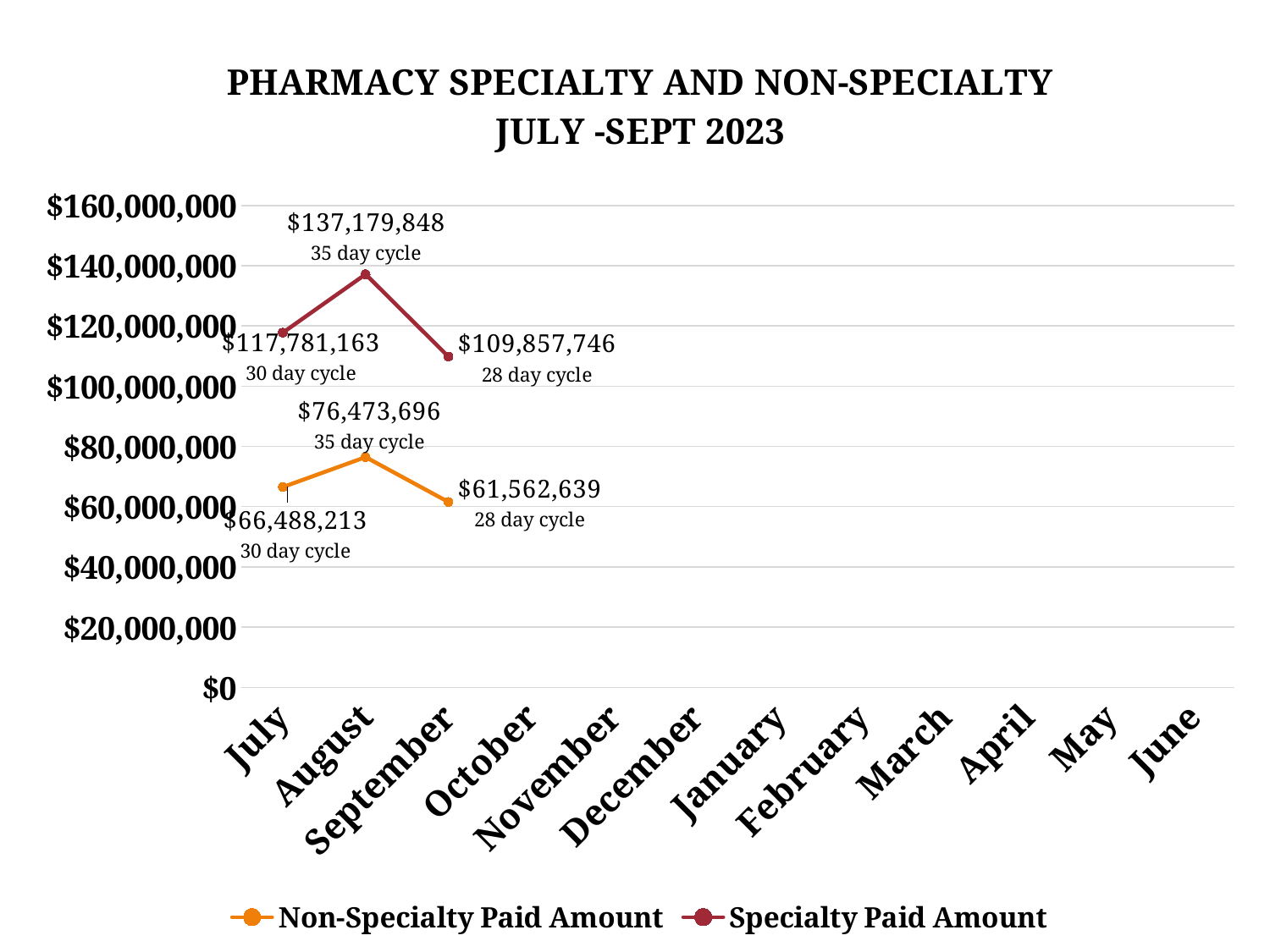
Is the Non-Specialty Paid Amount for August greater or less than $80,000,000? less What kind of chart is shown on the slide? Line chart Which month has the highest Specialty Paid Amount? August How many months are labelled on the x axis? 12 What is the difference between the Specialty Paid Amount in August and in July? $19,398,685 What is the Specialty Paid Amount for August? $137,179,848 Which is larger, the Specialty Paid Amount in July or in September? July What is the Non-Specialty Paid Amount for July? $66,488,213 What is the Non-Specialty Paid Amount for September? $61,562,639 What is the difference between the Specialty Paid Amount and the Non-Specialty Paid Amount in August? $60,706,152 Which month has the lowest Non-Specialty Paid Amount? September How many series does the legend list? 2